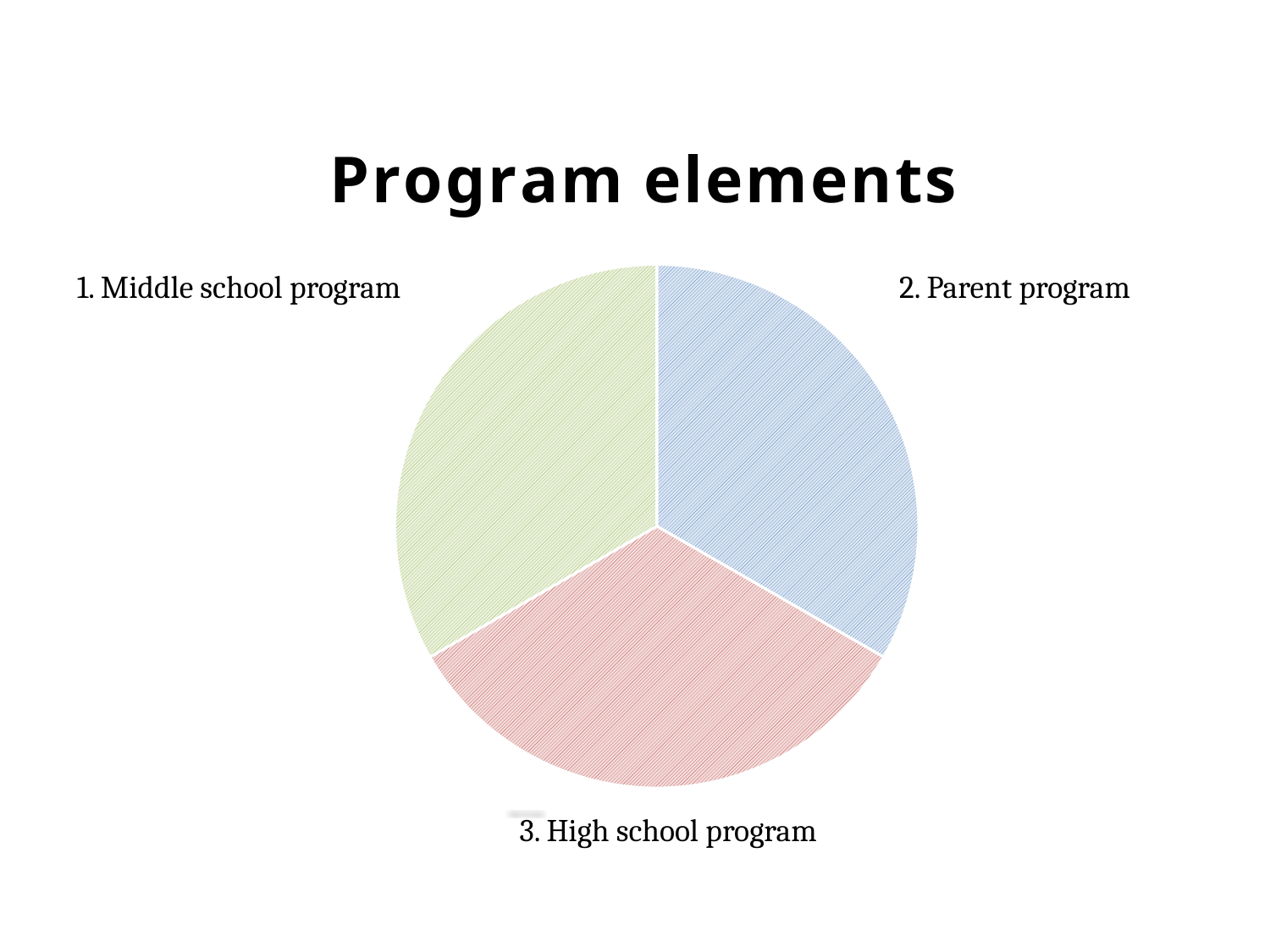
Which program element is labelled with the number 1 on the pie chart? Middle school program Which program element is labelled with the number 3 on the pie chart? High school program Which program element is shown by the blue slice of the pie chart? 2. Parent program What kind of chart is shown on the slide? Pie chart What is the title of the chart? Program elements How many slices does the pie chart have? 3